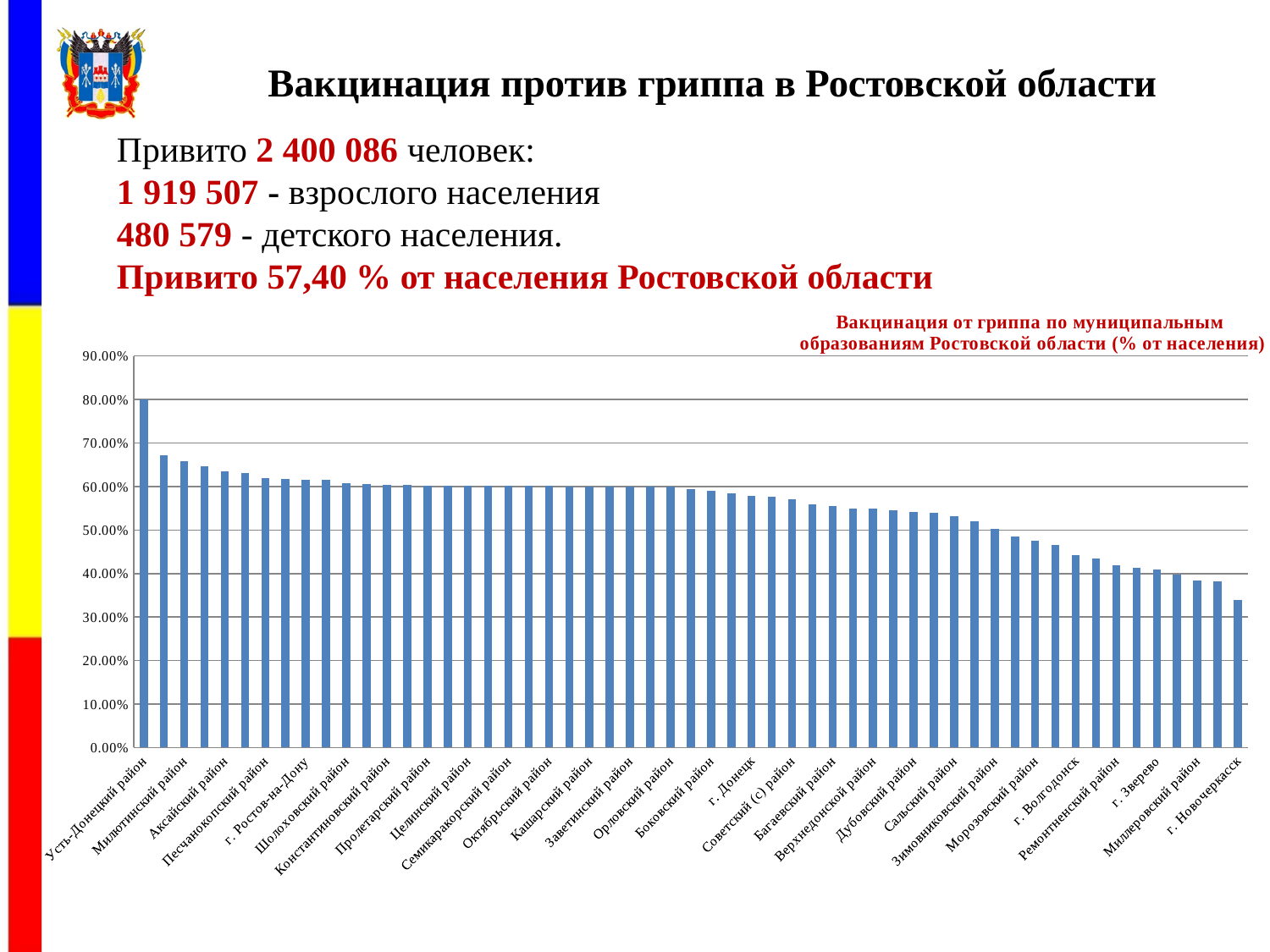
Is the value for Милютинский район greater or less than 60.00%? greater Do the bar values rise or fall from left to right along the x axis? fall Which municipality has the lowest vaccination rate in the chart? г. Новочеркасск Is the value for Миллеровский район greater or less than 50.00%? less Is the value for г. Новочеркасск greater or less than 40.00%? less What is the title of the chart? Вакцинация от гриппа по муниципальным образованиям Ростовской области (% от населения) Which municipality has the highest vaccination rate in the chart? Усть-Донецкий район What kind of chart is shown on the slide? bar chart Which has a higher vaccination rate, Аксайский район or г. Зверево? Аксайский район